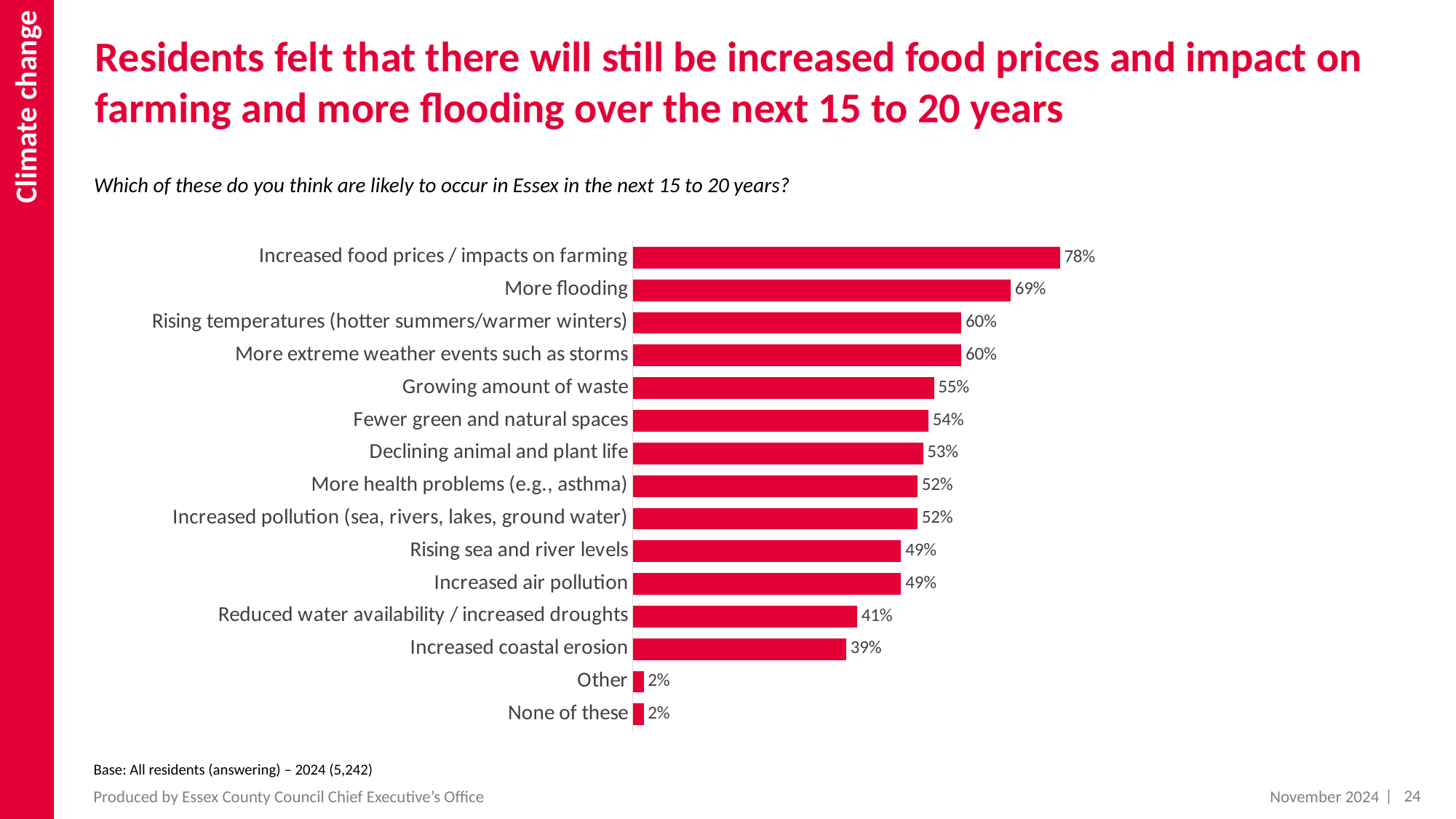
What is the value for 'Reduced water availability / increased droughts'? 41% Which is larger: the value for 'Increased coastal erosion' or the value for 'Rising sea and river levels'? Rising sea and river levels How many categories are shown in the chart? 15 What is the value shown for 'More flooding'? 69% Which category has the highest value in the chart? Increased food prices / impacts on farming What is the difference in percentage points between 'Growing amount of waste' and 'Increased coastal erosion'? 16 What value is shown for both 'Other' and 'None of these'? 2% What percentage of residents think increased food prices / impacts on farming are likely to occur in Essex in the next 15 to 20 years? 78% What percentage is shown for 'Increased coastal erosion'? 39% Which is larger: the value for 'More flooding' or the value for 'Rising temperatures (hotter summers/warmer winters)'? More flooding What is the difference in percentage points between 'Increased food prices / impacts on farming' and 'More flooding'? 9 What kind of chart is shown on the slide? Bar chart